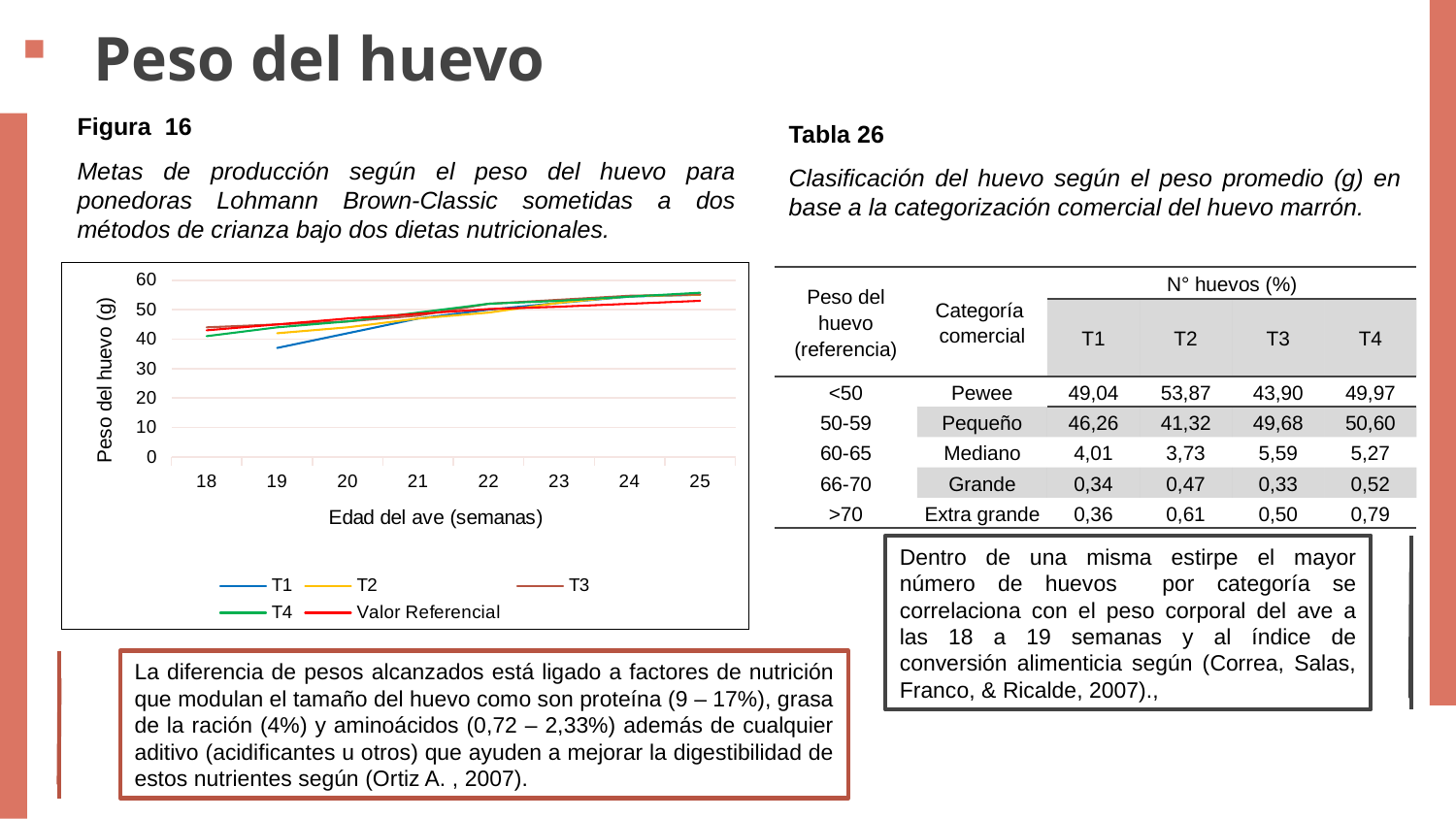
What is the label of the x axis in the Figura 16 chart? Edad del ave (semanas) How many age values (weeks) are shown on the x axis of the Figura 16 chart? 8 How many series does the legend of the Figura 16 chart list? 5 In the Figura 16 chart, do the egg weight values rise or fall as the bird's age increases from 18 to 25 weeks? rise In the Figura 16 chart, is the value for T4 at week 25 greater or less than 50? greater What is the label of the y axis in the Figura 16 chart? Peso del huevo (g) In the Figura 16 chart, is the value for T1 at week 19 greater or less than 40? less In the Figura 16 chart, is the value for Valor Referencial at week 18 greater or less than 40? greater In the Figura 16 chart, which is larger at week 19: the value for T1 or the value for Valor Referencial? Valor Referencial What kind of chart is shown in Figura 16? line chart In the Figura 16 chart, which series has the lowest value at week 19? T1